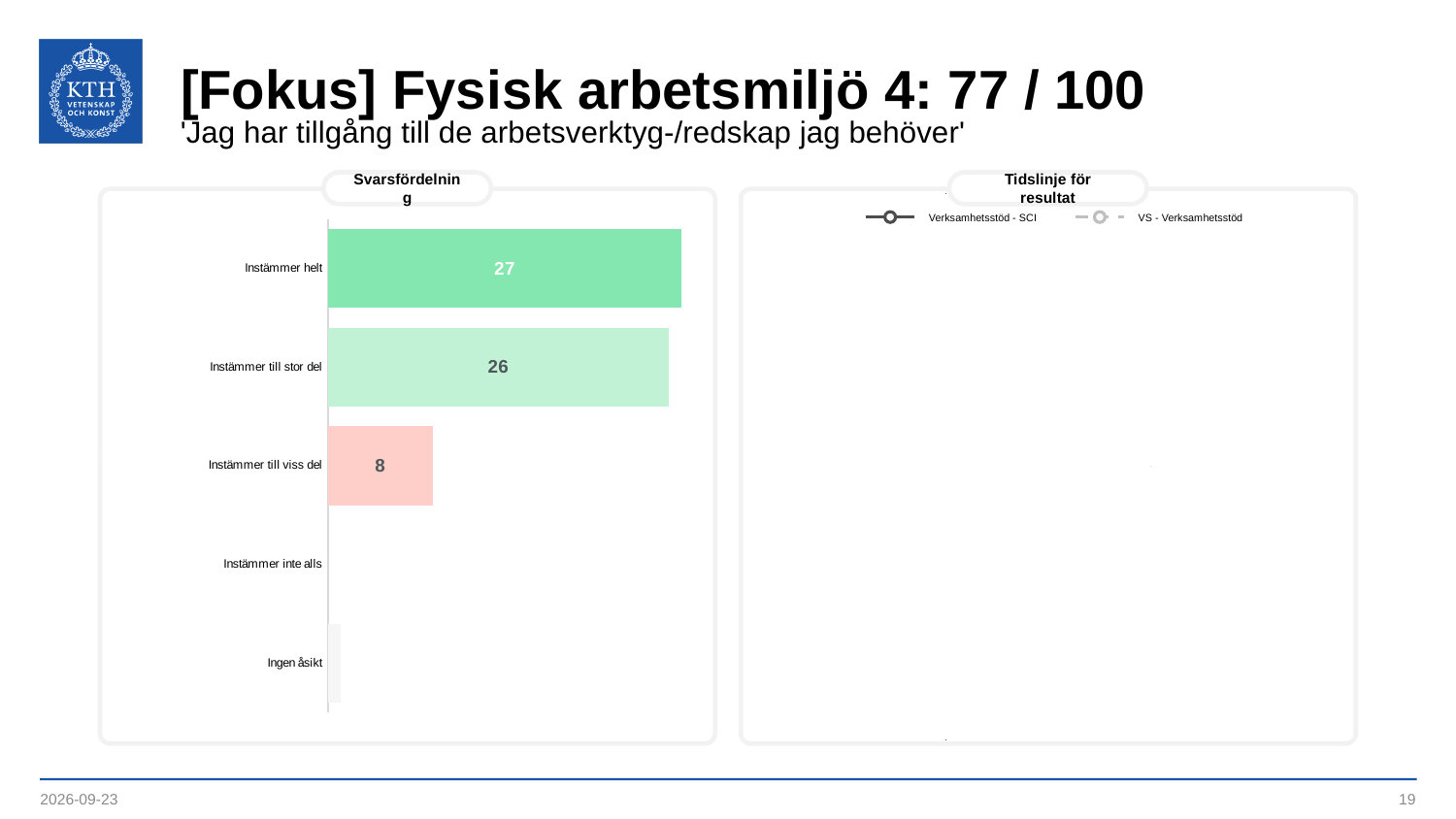
In the Svarsfördelning chart, what is the value for Instämmer helt? 27 In the Svarsfördelning chart, which is larger: Instämmer till stor del or Instämmer till viss del? Instämmer till stor del In the Svarsfördelning chart, what is the difference between Instämmer helt and Instämmer till viss del? 19 What kind of chart is the Svarsfördelning chart? Bar chart What are the legend entries of the Tidslinje för resultat chart? Verksamhetsstöd - SCI and VS - Verksamhetsstöd In the Svarsfördelning chart, what is the difference between Instämmer helt and Instämmer till stor del? 1 In the Svarsfördelning chart, what is the value for Instämmer till viss del? 8 How many series does the legend of the Tidslinje för resultat chart list? 2 In the Svarsfördelning chart, what is the value for Instämmer till stor del? 26 In the Svarsfördelning chart, which category has the highest value? Instämmer helt In the Svarsfördelning chart, what is the difference between Instämmer till stor del and Instämmer till viss del? 18 How many categories are shown in the Svarsfördelning chart? 5